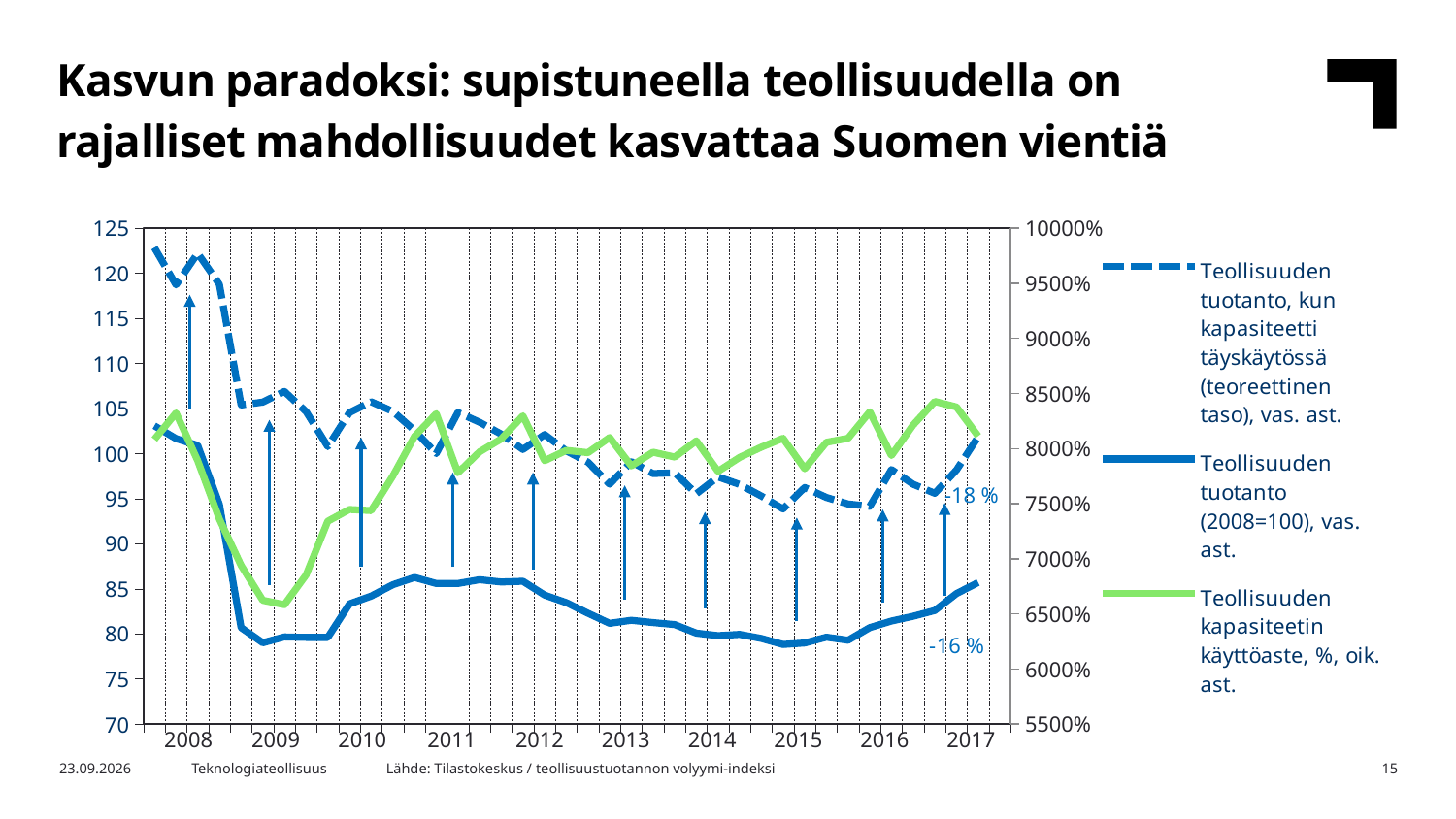
Does the solid blue line (Teollisuuden tuotanto, 2008=100) rise or fall between 2016 and 2017? rise Is the value of the dashed blue line (Teollisuuden tuotanto, kun kapasiteetti täyskäytössä) at the start of 2008 greater or less than 115? greater Is the value of the solid blue line (Teollisuuden tuotanto, 2008=100) at 2017 greater or less than 90? less At 2017, which is higher on the left axis: the dashed blue line or the solid blue line? the dashed blue line What is the highest value shown on the right-hand axis? 10000% What percentage change is annotated next to the solid blue line (Teollisuuden tuotanto) at the right end of the chart? -16 % Which series is drawn in green? Teollisuuden kapasiteetin käyttöaste, %, oik. ast. What percentage change is annotated next to the dashed blue line (Teollisuuden tuotanto, kun kapasiteetti täyskäytössä) at the right end of the chart? -18 % What kind of chart is shown on the slide? line chart How many years are labelled on the x axis? 10 How many series does the legend list? 3 Does the solid blue line (Teollisuuden tuotanto, 2008=100) rise or fall between 2008 and 2009? fall